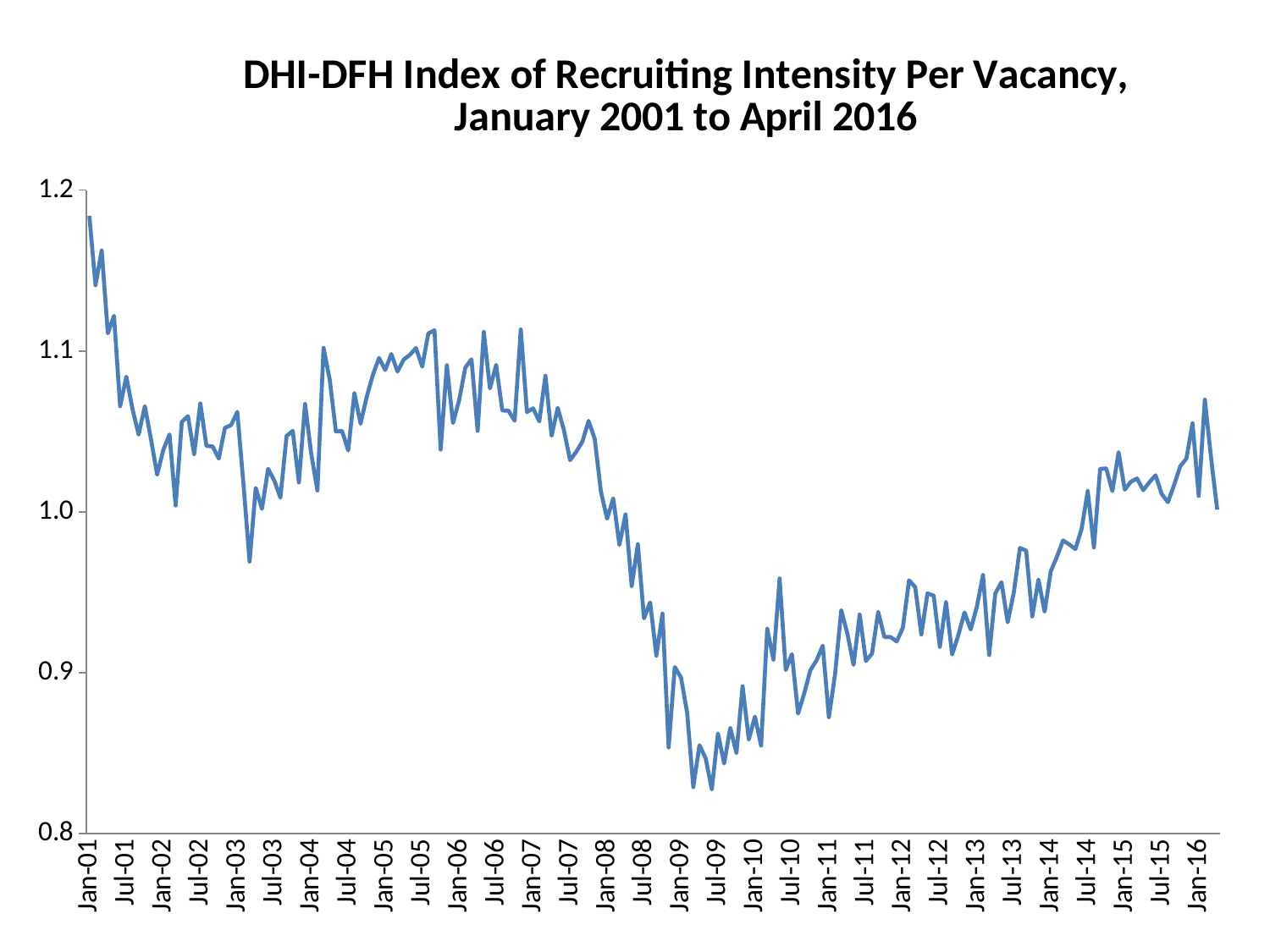
What is the title of the chart? DHI-DFH Index of Recruiting Intensity Per Vacancy, January 2001 to April 2016 Is the value at Jan-06 greater or less than 1.0? greater Does the index generally rise or fall between Jul-09 and Jan-16? rise Around which x-axis label does the line reach its lowest point? Jul-09 Is the value at Jul-09 greater or less than 0.9? less Is the value at Jan-10 greater or less than 0.9? less What kind of chart is shown on the slide? line chart Does the index generally rise or fall between Jan-07 and Jan-09? fall Around which x-axis label does the line reach its highest point? Jan-01